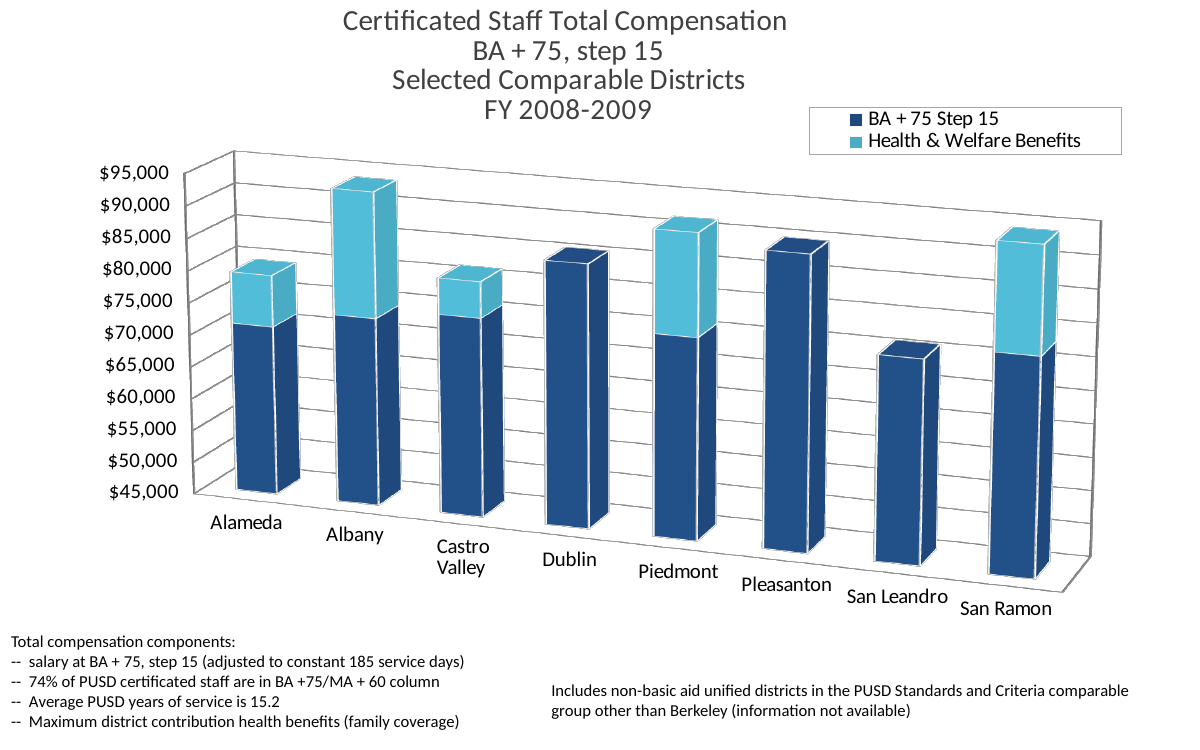
How many series does the chart's legend list? 2 Which has the larger total compensation bar, Piedmont or Castro Valley? Piedmont What fiscal year does the chart title say the data is for? FY 2008-2009 Which districts show no Health & Welfare Benefits segment on their bars? Dublin, Pleasanton, and San Leandro What kind of chart is shown on the slide? Stacked bar chart Which has the larger total compensation bar, Albany or Alameda? Albany How many districts are shown on the x axis of the chart? 8 Is the total compensation for Albany greater or less than $85,000? greater Which district has the lowest total compensation bar? San Leandro Is the total compensation for Castro Valley greater or less than $85,000? less